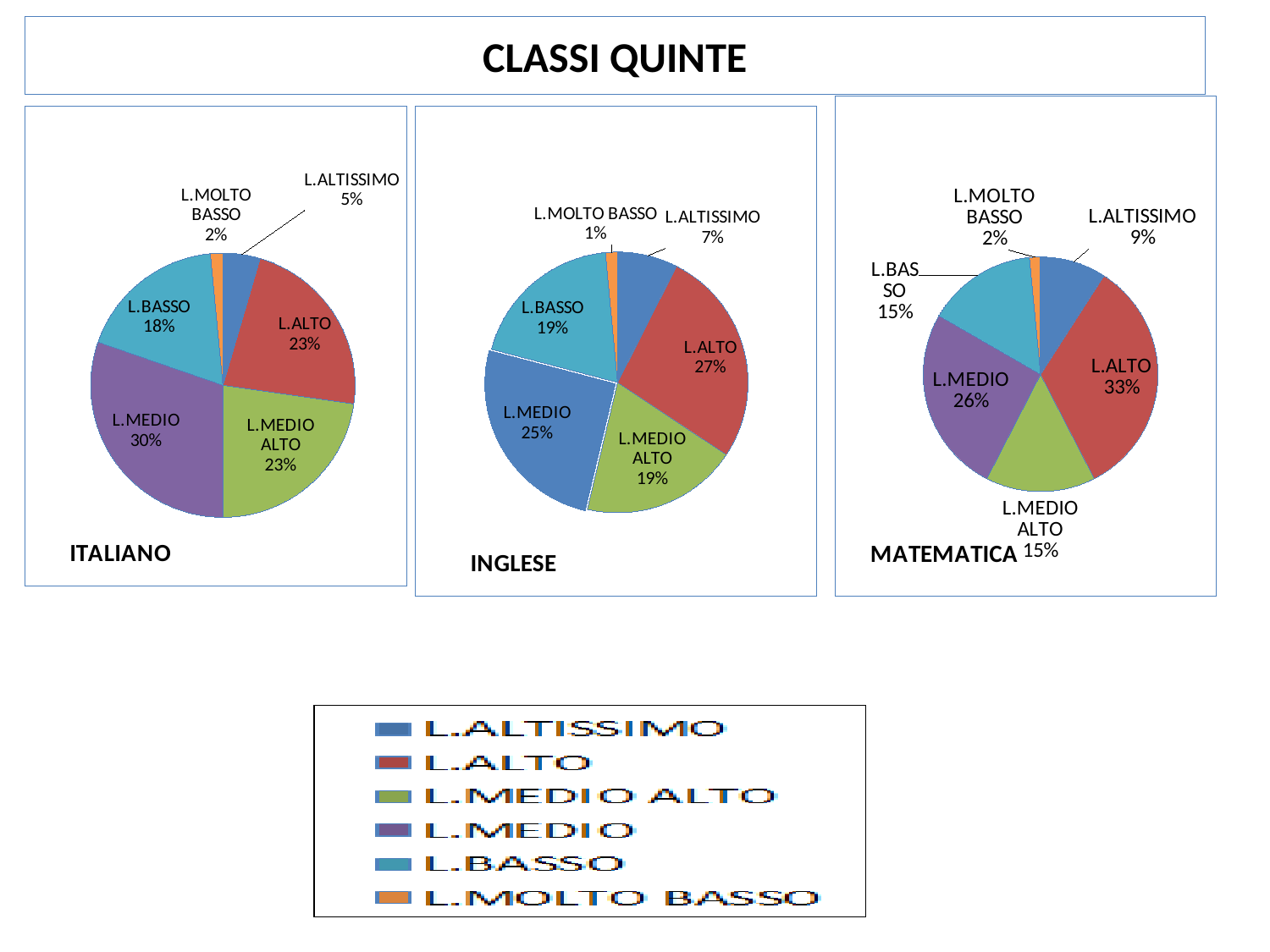
In the INGLESE chart, which category has the smallest slice? L.MOLTO BASSO How many categories does the legend at the bottom of the slide list? 6 In the INGLESE chart, what share does L.ALTO have? 27% In the ITALIANO chart, what is the difference between the L.MEDIO share and the L.BASSO share? 12% How many pie charts are shown on the slide? 3 In the MATEMATICA chart, what share does L.ALTISSIMO have? 9% In the ITALIANO chart, which category has the largest slice? L.MEDIO In the MATEMATICA chart, which is larger, L.MEDIO or L.MEDIO ALTO? L.MEDIO In the ITALIANO chart, what share does L.MEDIO have? 30% What kind of chart is the INGLESE chart? Pie chart What is the title at the top of the slide? CLASSI QUINTE In the MATEMATICA chart, which category has the largest slice? L.ALTO